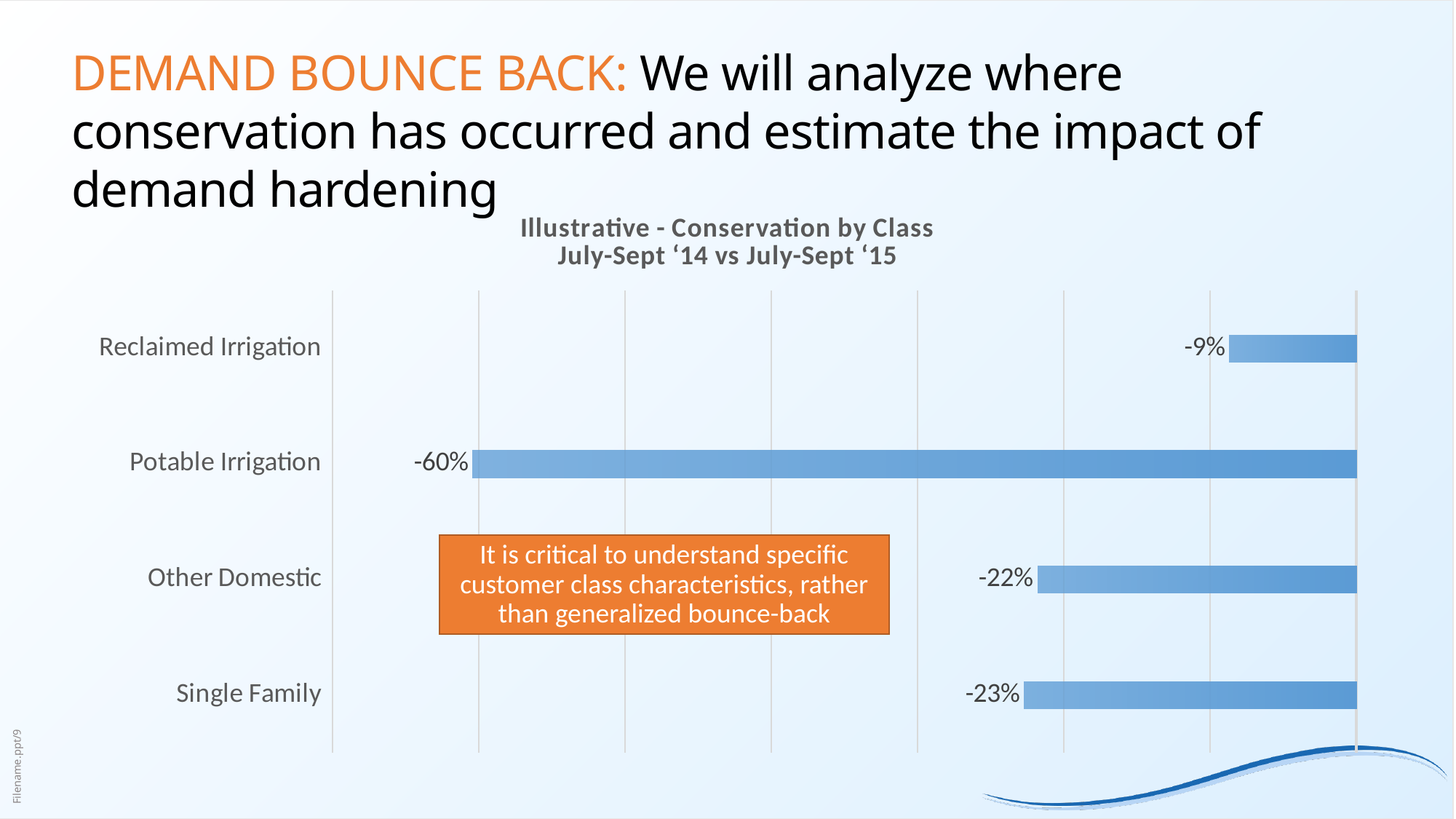
Which customer class shows the largest conservation (most negative value)? Potable Irrigation How many customer classes are plotted in the chart? 4 What is the title of the chart? Illustrative - Conservation by Class July-Sept '14 vs July-Sept '15 Which customer class shows the smallest conservation (value closest to zero)? Reclaimed Irrigation What is the value shown for Other Domestic? -22% What is the value shown for Reclaimed Irrigation? -9% By how many percentage points does the Single Family value differ from the Other Domestic value? 1 percentage point By how many percentage points does the Potable Irrigation value differ from the Reclaimed Irrigation value? 51 percentage points What is the value shown for Single Family? -23% Which shows a larger reduction, Single Family or Other Domestic? Single Family What is the value shown for Potable Irrigation? -60% What kind of chart is shown on the slide? Bar chart